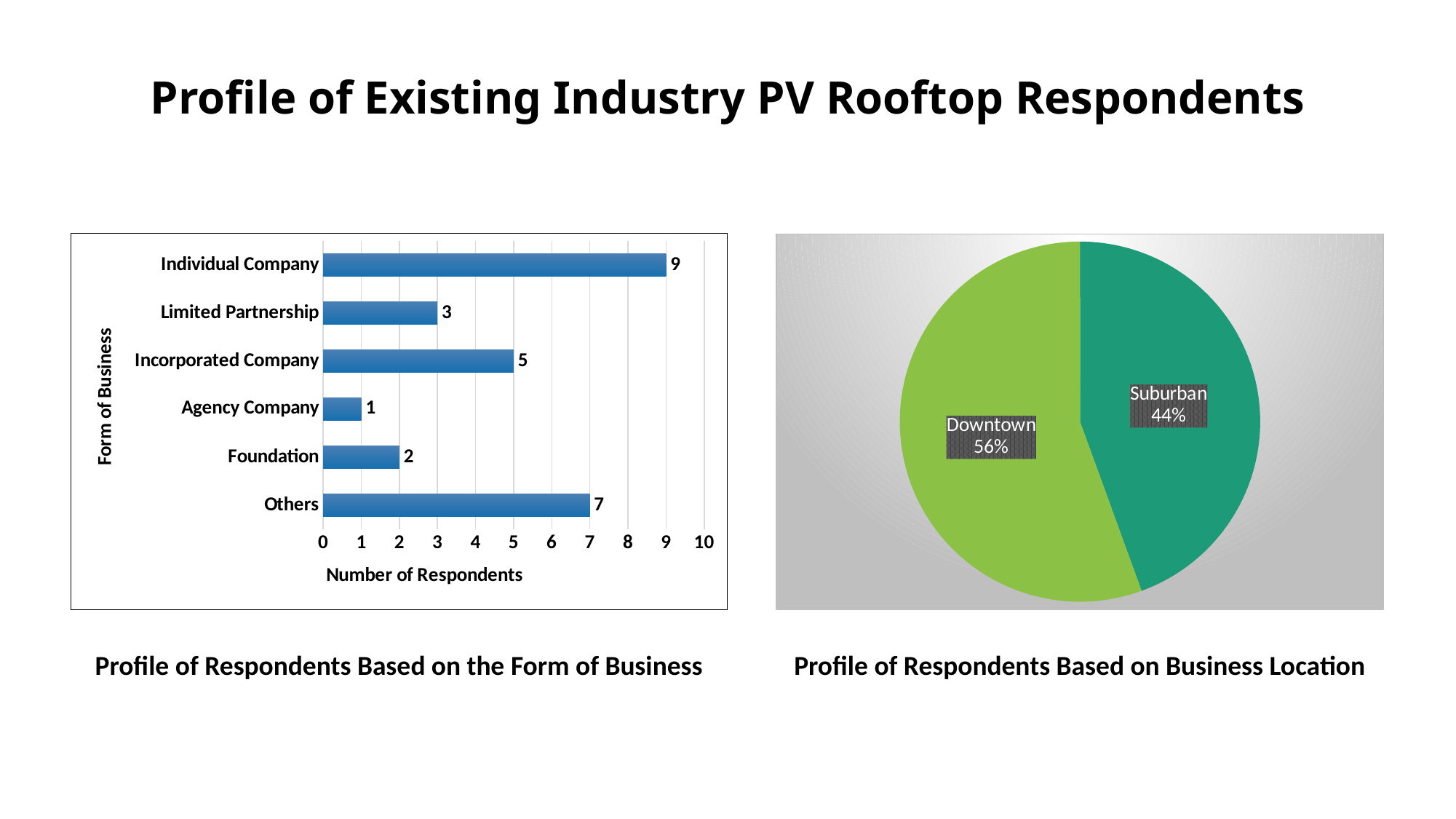
In the 'Profile of Respondents Based on Business Location' chart, what share of respondents are Suburban? 44% In the 'Profile of Respondents Based on the Form of Business' chart, which has more respondents, Limited Partnership or Incorporated Company? Incorporated Company In the 'Profile of Respondents Based on the Form of Business' chart, how many forms of business are shown? 6 In the 'Profile of Respondents Based on the Form of Business' chart, what is the difference between the number of respondents for Others and for Incorporated Company? 2 In the 'Profile of Respondents Based on the Form of Business' chart, what is the number of respondents for Foundation? 2 In the 'Profile of Respondents Based on the Form of Business' chart, which form of business has the highest number of respondents? Individual Company In the 'Profile of Respondents Based on the Form of Business' chart, what is the label of the horizontal axis? Number of Respondents In the 'Profile of Respondents Based on the Form of Business' chart, which form of business has the lowest number of respondents? Agency Company What kind of chart is 'Profile of Respondents Based on Business Location'? Pie chart What kind of chart is 'Profile of Respondents Based on the Form of Business'? Bar chart In the 'Profile of Respondents Based on Business Location' chart, what share of respondents are Downtown? 56% In the 'Profile of Respondents Based on the Form of Business' chart, how many respondents are Individual Companies? 9